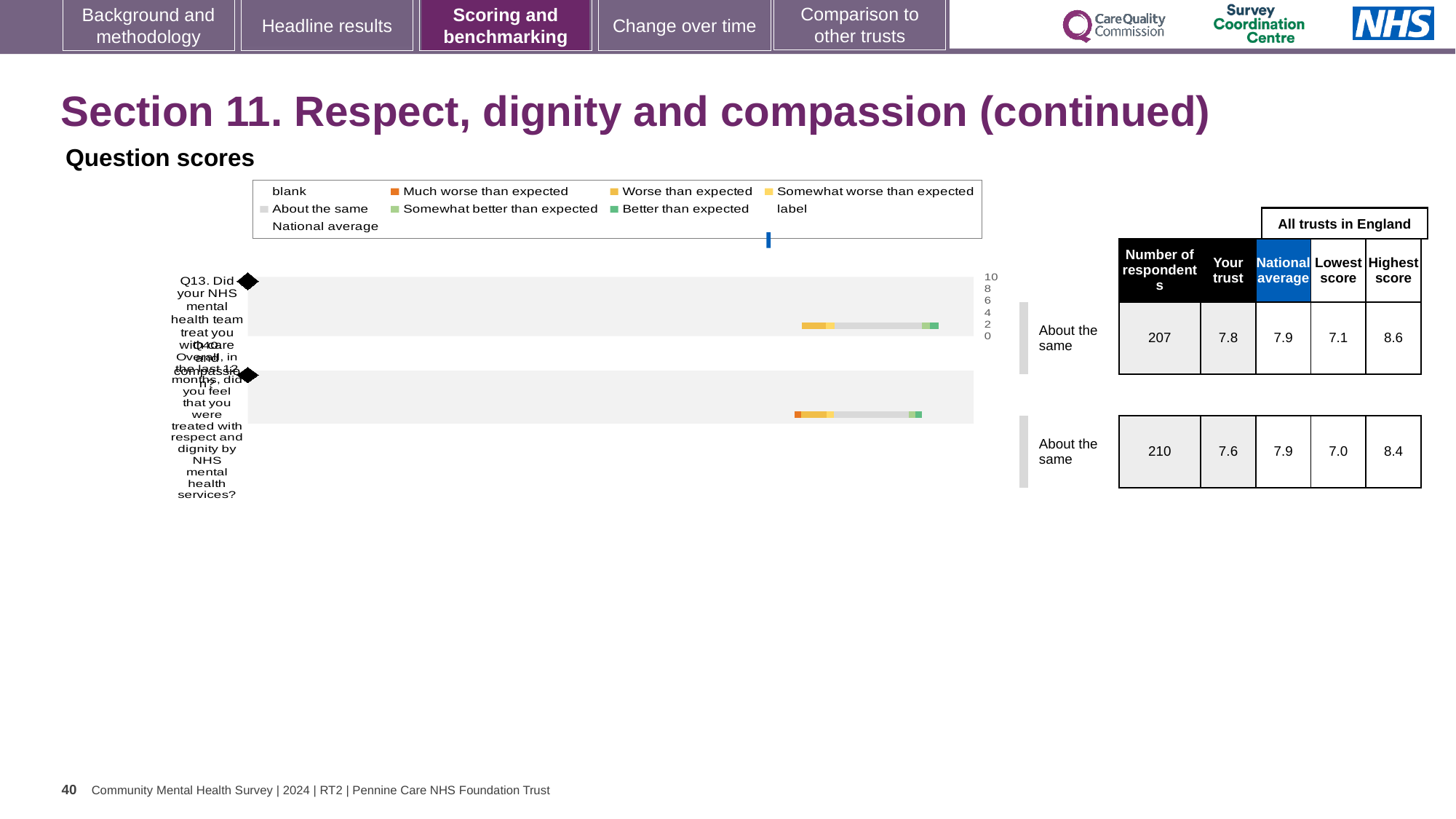
In the table next to the chart, what is the number of respondents for Q13? 207 Which benchmarking category is shown for Q14 in the Question scores chart? About the same How many entries does the legend of the Question scores chart list? 9 In the table next to the chart, what is the highest score among all trusts in England for Q14? 8.4 How many questions (categories) are plotted in the Question scores chart? 2 What kind of chart is shown under 'Question scores'? bar chart What is the difference between the national average and the 'Your trust' score for Q14 in the table? 0.3 In the table next to the chart, what is the lowest score among all trusts in England for Q13? 7.1 In the table next to the chart, what is the 'Your trust' score for Q13? 7.8 In the table next to the chart, what is the 'Your trust' score for Q14? 7.6 Which benchmarking category is shown for Q13 in the Question scores chart? About the same Which question has the higher 'Your trust' score in the table, Q13 or Q14? Q13